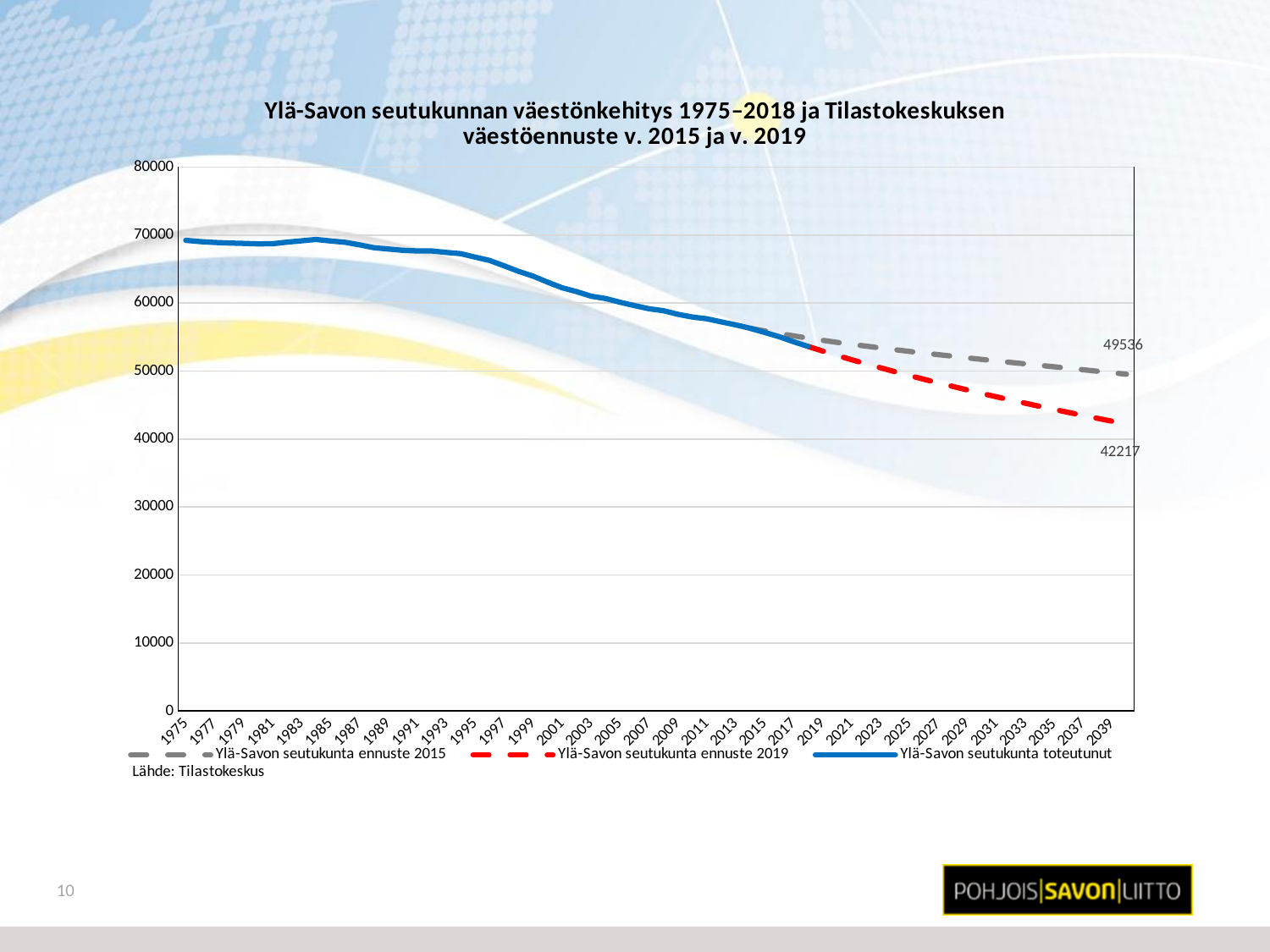
What is the difference between the final labelled values of the 2015 forecast (49536) and the 2019 forecast (42217)? 7319 What kind of chart is shown on the slide? line chart Is the value of the 'Ylä-Savon seutukunta toteutunut' series in 1975 greater or less than 60000? greater Which forecast series ends at a higher value, 'ennuste 2015' or 'ennuste 2019'? Ylä-Savon seutukunta ennuste 2015 What is the final labelled value of the 'Ylä-Savon seutukunta ennuste 2015' series? 49536 Does the 'Ylä-Savon seutukunta toteutunut' series rise or fall overall from 1975 to 2018? fall Is the value of the 'Ylä-Savon seutukunta ennuste 2019' series in 2039 greater or less than 50000? less What is the highest value shown on the vertical axis? 80000 What is the final labelled value of the 'Ylä-Savon seutukunta ennuste 2019' series? 42217 What source is cited below the chart? Lähde: Tilastokeskus How many series does the legend list? 3 Is the value of the 'Ylä-Savon seutukunta toteutunut' series in 2017 greater or less than 60000? less